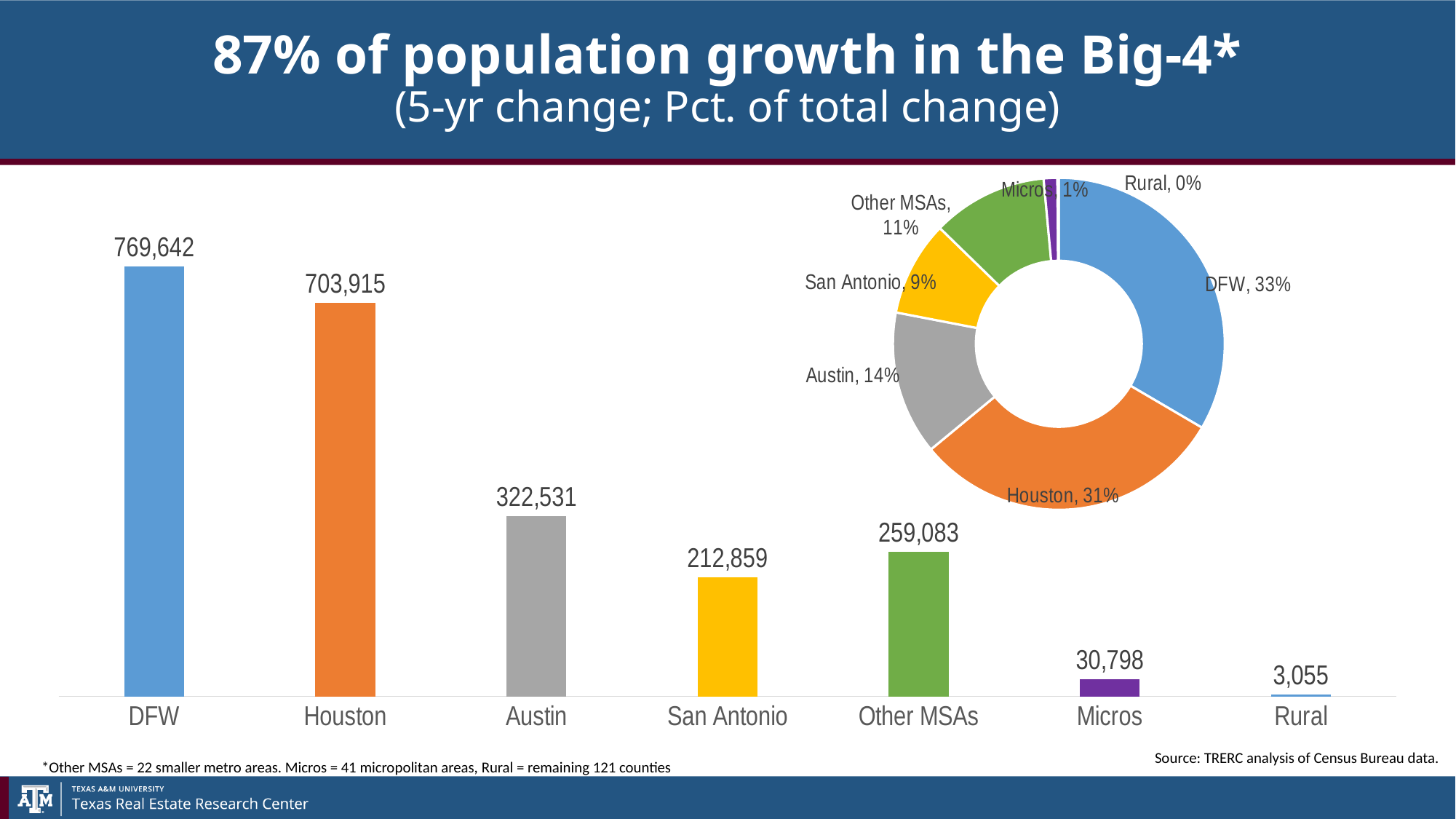
In the bar chart, which category has the highest value? DFW In the bar chart, what is the value for Austin? 322,531 How many categories does the bar chart show? 7 In the bar chart, which is larger, the value for Other MSAs or the value for San Antonio? Other MSAs In the bar chart, which category has the lowest value? Rural In the donut chart, what share does Houston have? 31% In the bar chart, what is the value for Rural? 3,055 In the bar chart, what is the value for Houston? 703,915 What kind of chart is the chart on the left side of the slide? Bar chart In the bar chart, what is the difference between the values for DFW and Houston? 65,727 What kind of chart is the chart on the right side of the slide? Donut chart In the donut chart, what share does Austin have? 14%